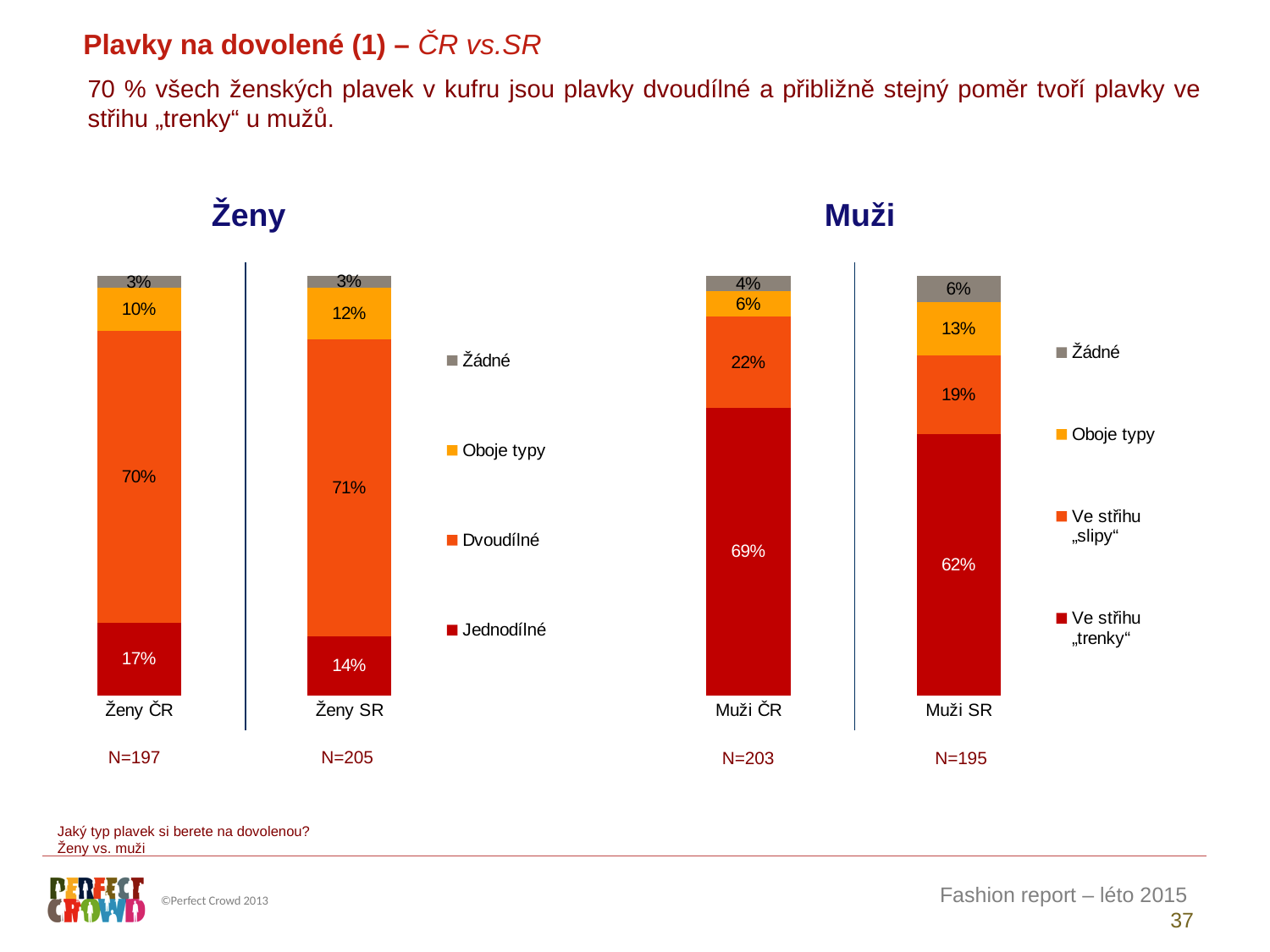
How many series does the legend of the Muži chart list? 4 In the Muži chart, what is the value for Ve střihu „slipy“ for Muži ČR? 22% In the Ženy chart, what is the value for Dvoudílné for Ženy ČR? 70% In the Muži chart, which is larger: Ve střihu „trenky“ for Muži ČR or for Muži SR? Muži ČR In the Ženy chart, what is the difference between the Jednodílné values for Ženy ČR and Ženy SR? 3% In the Ženy chart, what is the value for Jednodílné for Ženy SR? 14% How many bars are plotted in the Ženy chart? 2 In the Muži chart, what is the difference between the Oboje typy values for Muži SR and Muži ČR? 7% What kind of chart is the Ženy chart? Stacked bar chart In the Ženy chart, which segment is the largest for Ženy SR? Dvoudílné In the Muži chart, what is the value for Ve střihu „trenky“ for Muži SR? 62% In the Muži chart, which segment is the smallest for Muži ČR? Žádné